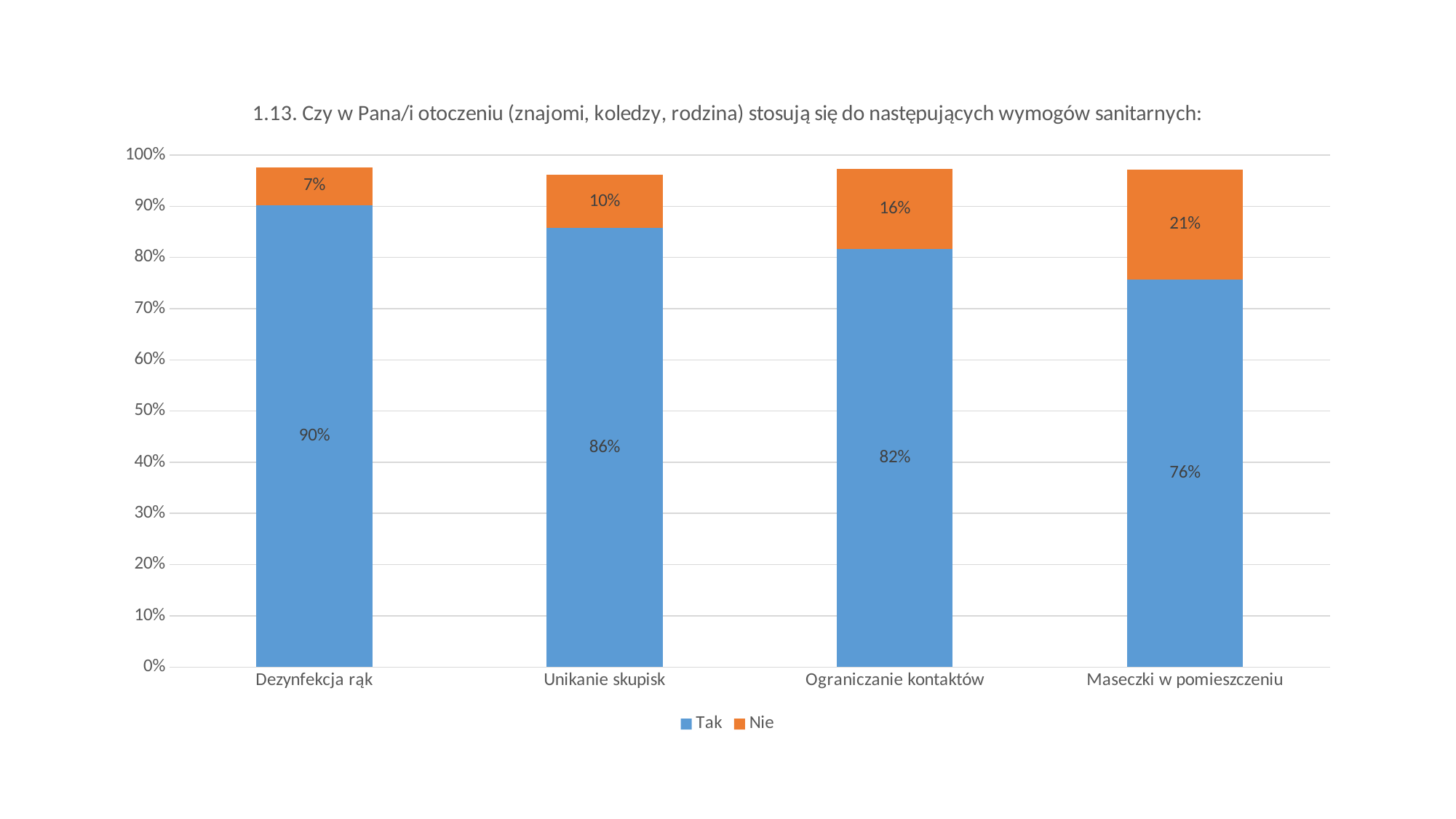
What is the "Nie" value for Unikanie skupisk? 10% What is the "Tak" value for Ograniczanie kontaktów? 82% What kind of chart is shown on the slide? Stacked bar chart Which category has the lowest "Nie" value? Dezynfekcja rąk Do the "Tak" values rise or fall from left to right along the x axis? Fall What is the difference between the "Tak" values for Dezynfekcja rąk and Maseczki w pomieszczeniu? 14% How many categories are shown on the x axis? 4 What is the "Nie" value for Maseczki w pomieszczeniu? 21% How many series does the legend list? 2 Which category has the highest "Tak" value? Dezynfekcja rąk Which is larger: the "Nie" value for Ograniczanie kontaktów or the "Nie" value for Unikanie skupisk? Ograniczanie kontaktów What is the "Tak" value for Dezynfekcja rąk? 90%